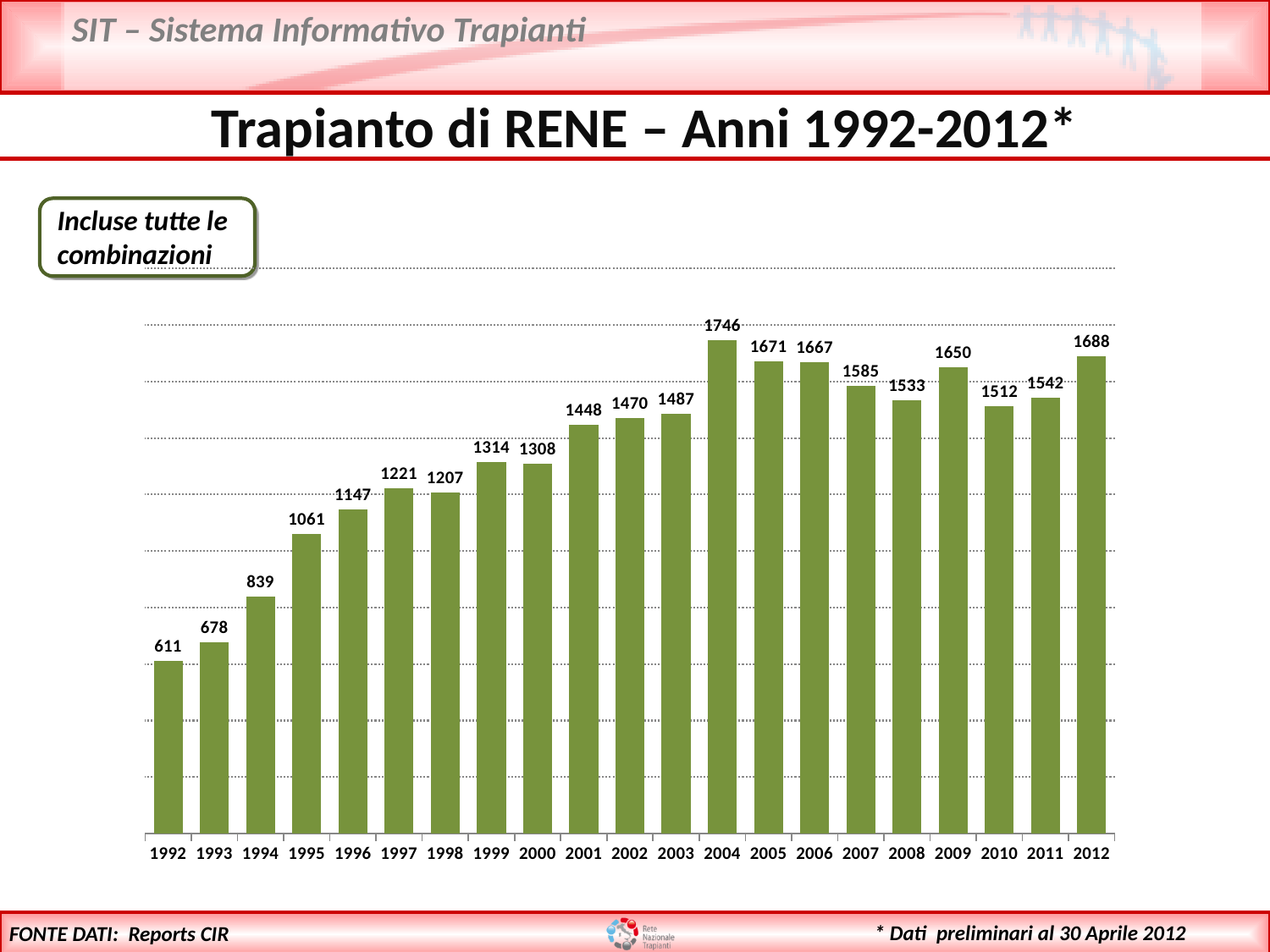
What is the value for 2012? 1688 Which is larger, the value for 1997 or the value for 1998? 1997 Which year has the highest value? 2004 How many years are shown on the x axis? 21 What is the value for 1999? 1314 Which year has the lowest value? 1992 What is the value for 1992? 611 What is the difference between the values for 2012 and 2011? 146 What type of chart is shown on the slide? bar chart What is the title of the slide containing the chart? Trapianto di RENE – Anni 1992-2012* What is the difference between the values for 2004 and 1992? 1135 What is the value for 2004? 1746